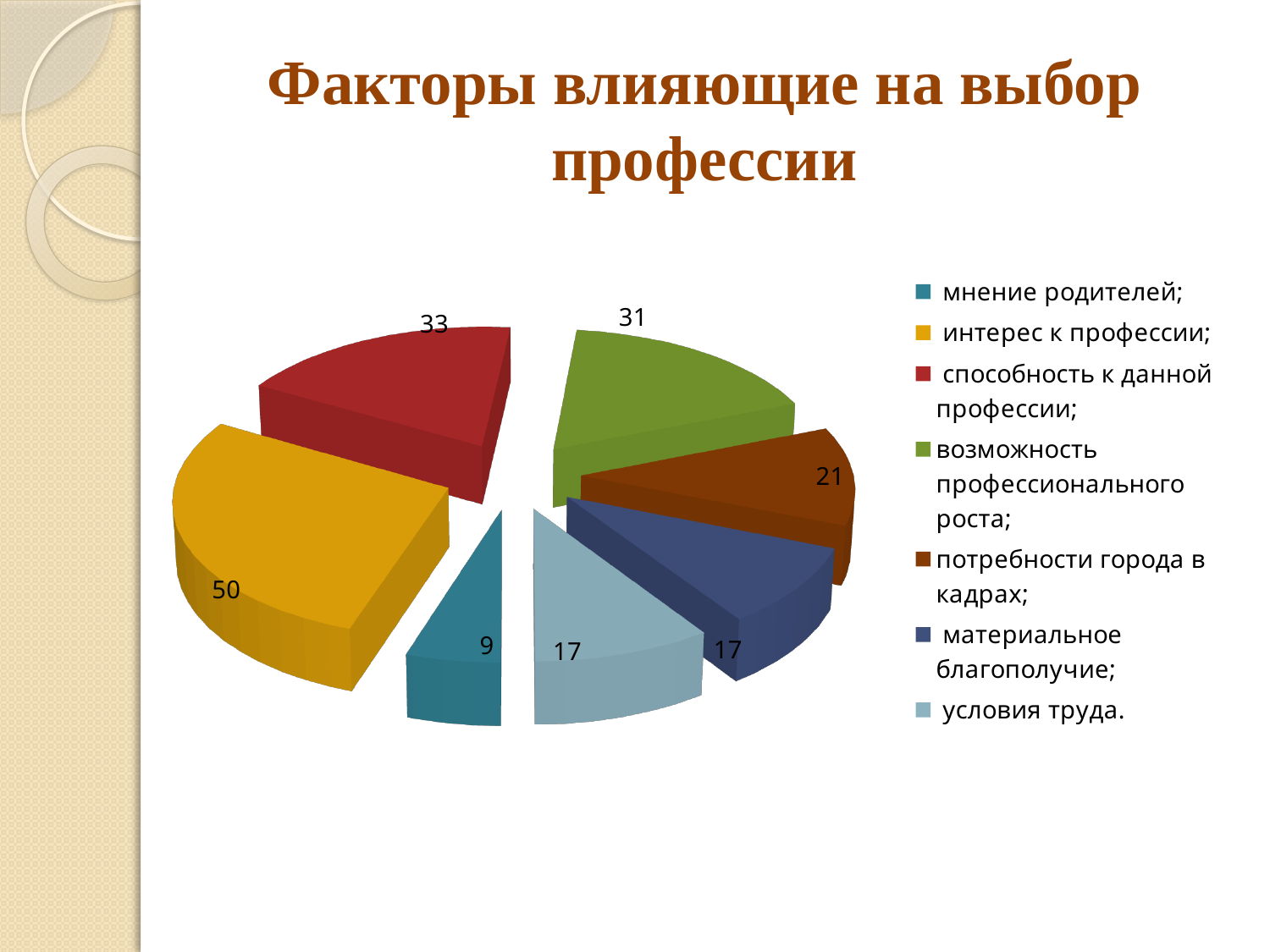
What is the value for «способность к данной профессии»? 33 Which is larger: the value for «возможность профессионального роста» or the value for «потребности города в кадрах»? возможность профессионального роста What is the value for «мнение родителей»? 9 What kind of chart is shown on the slide? pie chart What is the value for «возможность профессионального роста»? 31 What is the value for «интерес к профессии»? 50 What is the title of the slide containing the chart? Факторы влияющие на выбор профессии How many categories does the pie chart have? 7 What is the value for «потребности города в кадрах»? 21 Which category has the largest slice of the pie? интерес к профессии Which category has the smallest slice of the pie? мнение родителей What is the difference between the values for «интерес к профессии» and «способность к данной профессии»? 17